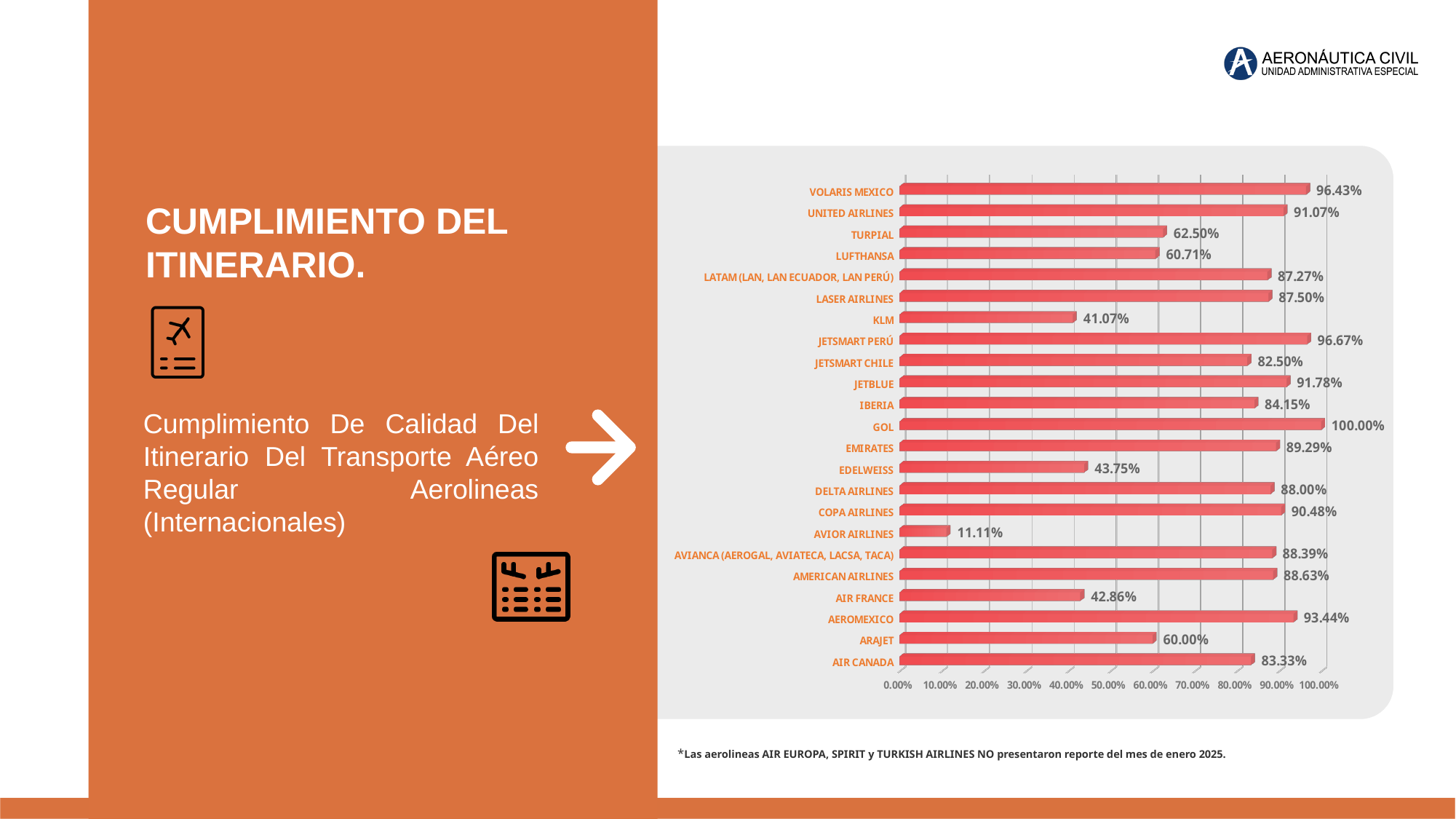
What is the value for EDELWEISS? 43.75% How many airlines are shown in the chart? 23 What is the difference between the values for AEROMEXICO and ARAJET? 33.44% What is the value for AIR CANADA? 83.33% What kind of chart is shown on the slide? bar chart Which airline has the lowest value? AVIOR AIRLINES What is the difference between the values for VOLARIS MEXICO and UNITED AIRLINES? 5.36% Is the value for AIR FRANCE greater or less than 50.00%? less What is the value for KLM? 41.07% Which airline has the highest value? GOL Which is larger, the value for TURPIAL or the value for LUFTHANSA? TURPIAL What is the value for JETSMART PERÚ? 96.67%